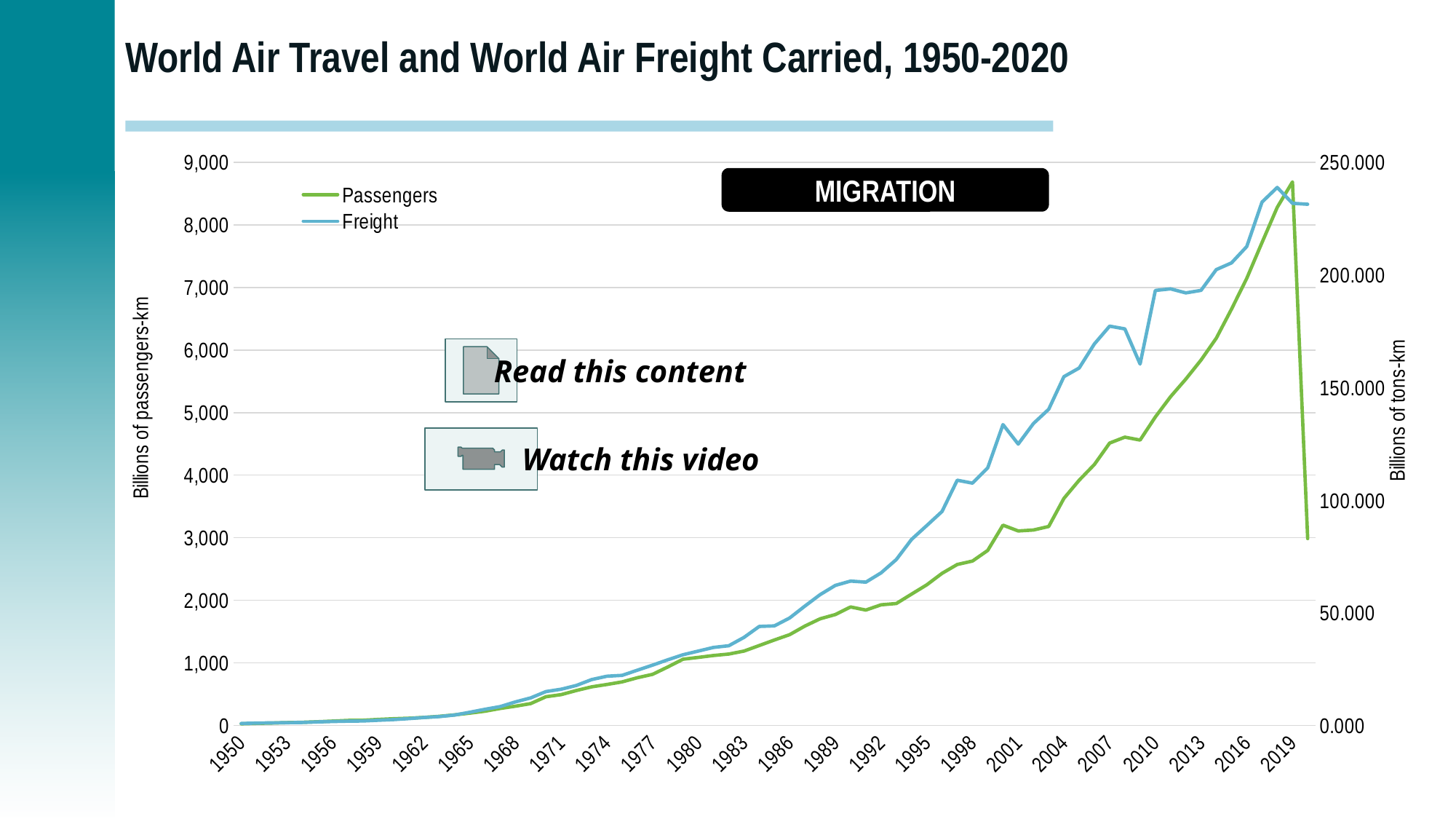
Is the Passengers value for 1980 greater or less than 2,000? less What is the label of the left vertical axis? Billions of passengers-km Is the Passengers value for 2020 greater or less than 4,000? less Is the Freight value for 1995 greater or less than 100.000? less What kind of chart is shown on the slide? Line chart How many series does the chart legend list? 2 What is the title of the chart on the slide? World Air Travel and World Air Freight Carried, 1950-2020 Does the Passengers series rise or fall between 1950 and 2019? Rise